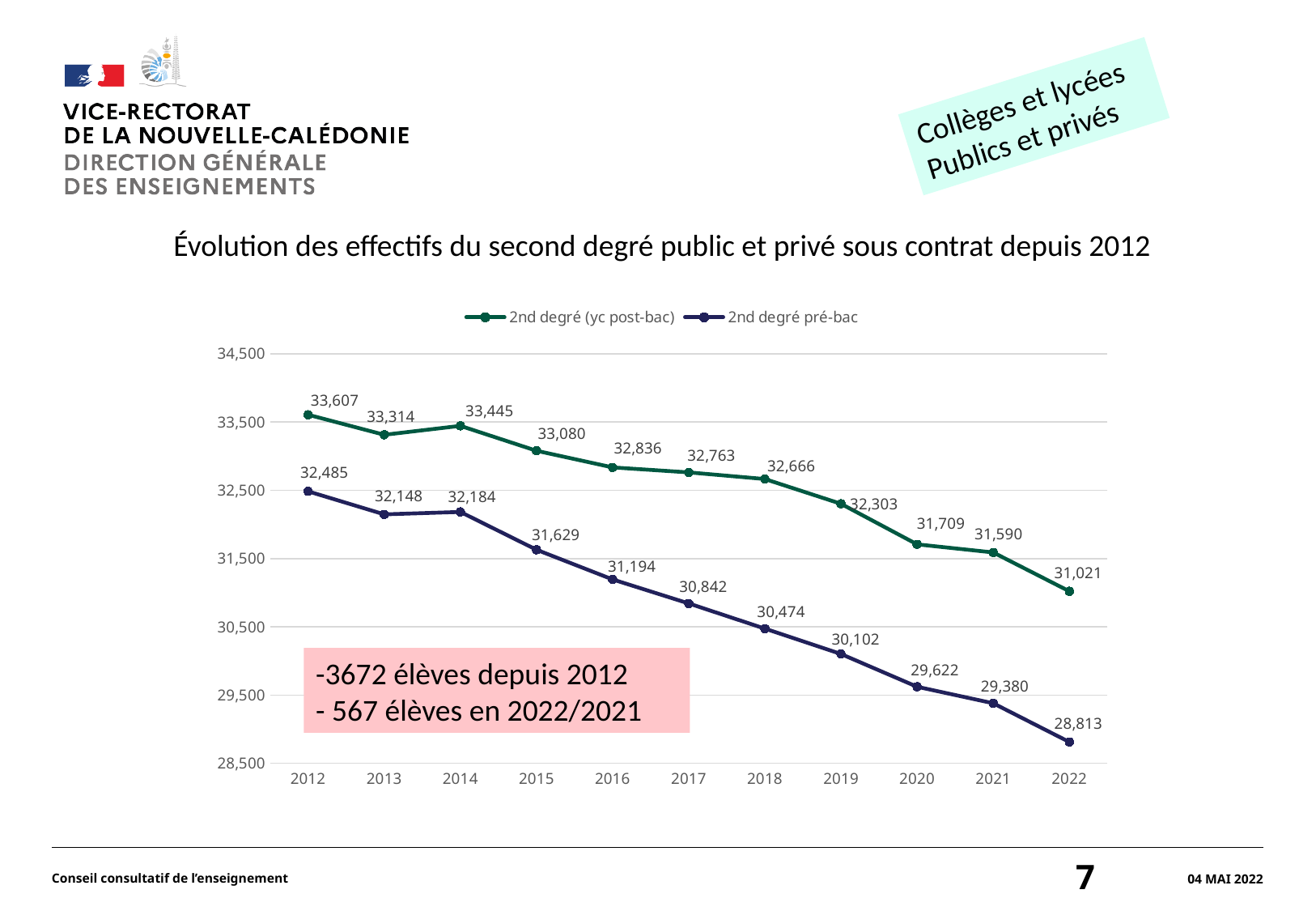
What is the value of the '2nd degré pré-bac' series in 2022? 28,813 What is the difference between the two series in 2022? 2,208 In which year is the '2nd degré (yc post-bac)' series at its lowest? 2022 What type of chart is shown on the slide? line chart What is the value of the '2nd degré pré-bac' series in 2017? 30,842 How many series does the legend list? 2 How many years are plotted on the x axis? 11 What is the value of the '2nd degré (yc post-bac)' series in 2012? 33,607 In which year is the '2nd degré pré-bac' series at its highest? 2012 By how much did the '2nd degré pré-bac' series decrease between 2012 and 2022? 3,672 Which is larger: the '2nd degré (yc post-bac)' value in 2014 or in 2013? 2014 What is the overall trend of the '2nd degré pré-bac' series from 2012 to 2022? falling